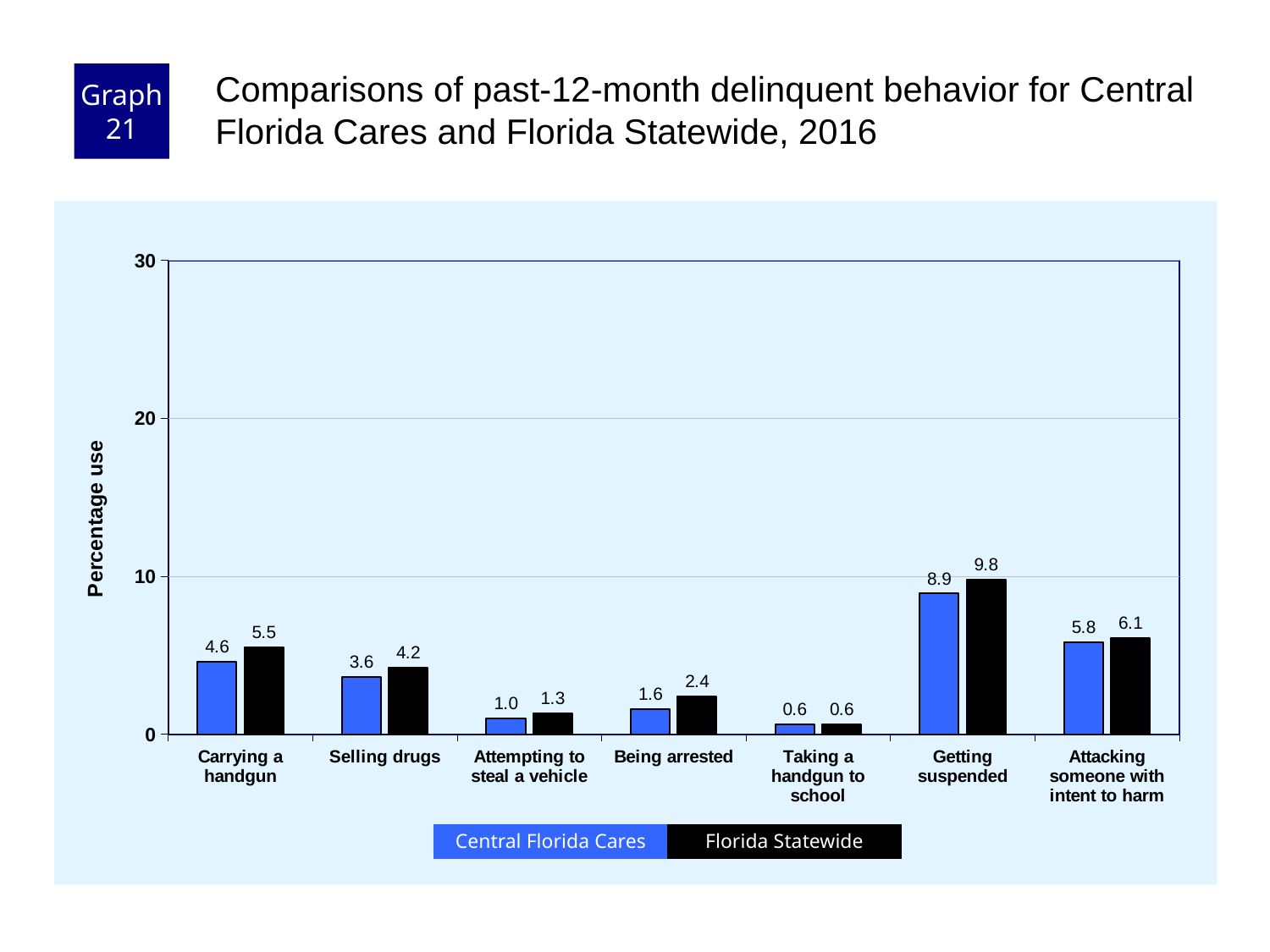
What is the difference between the Florida Statewide and Central Florida Cares values for Carrying a handgun? 0.9 What is the Florida Statewide value for Being arrested? 2.4 Which category has the lowest Central Florida Cares value? Taking a handgun to school What is the Central Florida Cares value for Getting suspended? 8.9 How many categories are shown on the x axis? 7 Which category has the highest Florida Statewide value? Getting suspended What kind of chart is shown on the slide? Bar chart Which is larger for Selling drugs: the Central Florida Cares value or the Florida Statewide value? Florida Statewide How many series does the legend list? 2 What is the label of the y axis? Percentage use What is the Central Florida Cares value for Carrying a handgun? 4.6 Is the Florida Statewide value for Getting suspended greater or less than 10? less